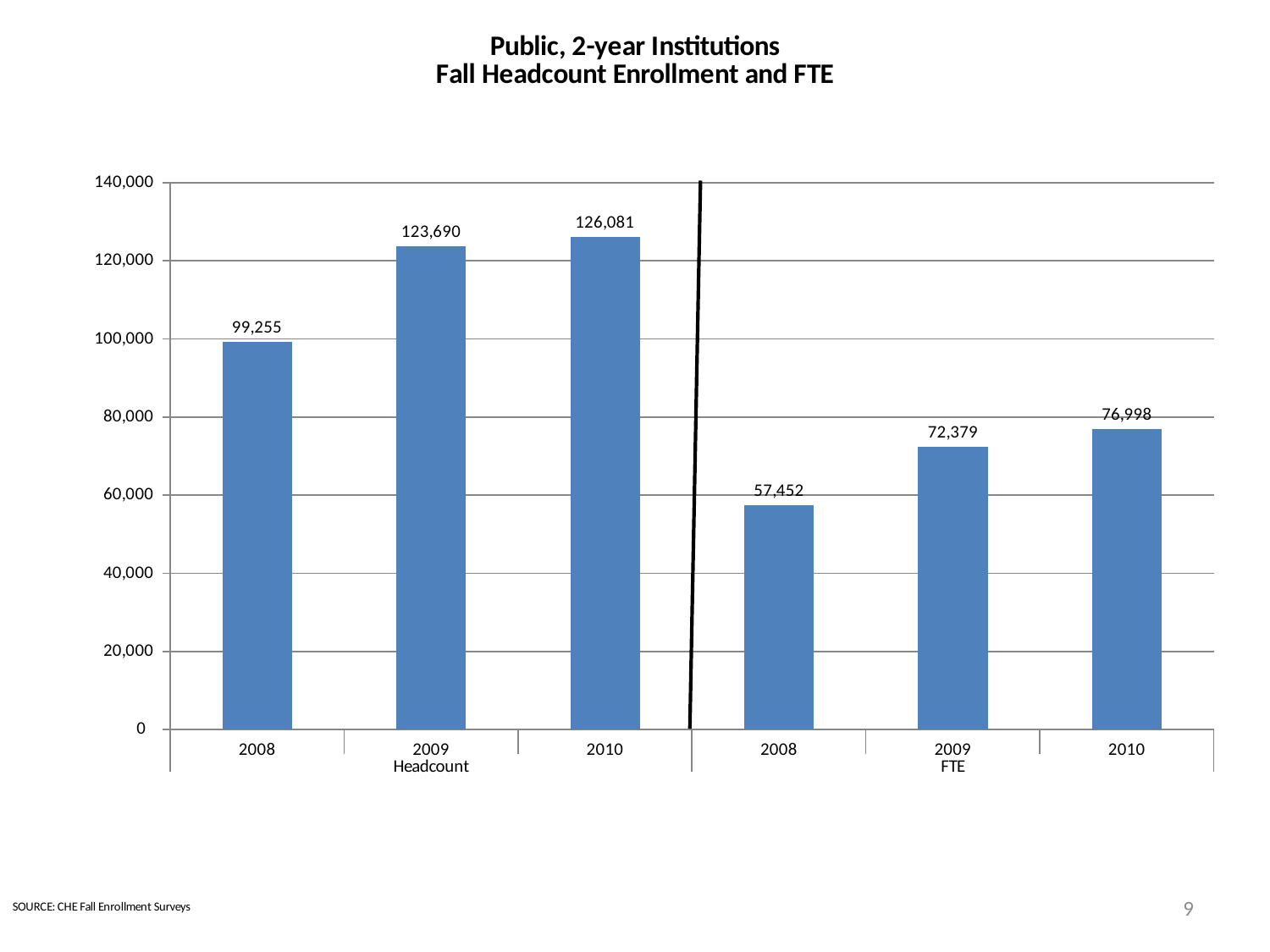
Which year has the lowest FTE? 2008 What kind of chart is shown on the slide? bar chart What is the FTE value for 2010? 76,998 Which is larger, the Headcount for 2008 or the FTE for 2010? Headcount for 2008 Which year has the highest Headcount? 2010 How many bars are plotted on the chart? 6 Do the Headcount values rise or fall from 2008 to 2010? rise What is the difference between the Headcount for 2010 and the Headcount for 2008? 26,826 What is the FTE value for 2008? 57,452 What is the difference between the FTE for 2009 and the FTE for 2008? 14,927 Is the FTE value for 2009 greater or less than 80,000? less What is the Headcount value for 2009? 123,690